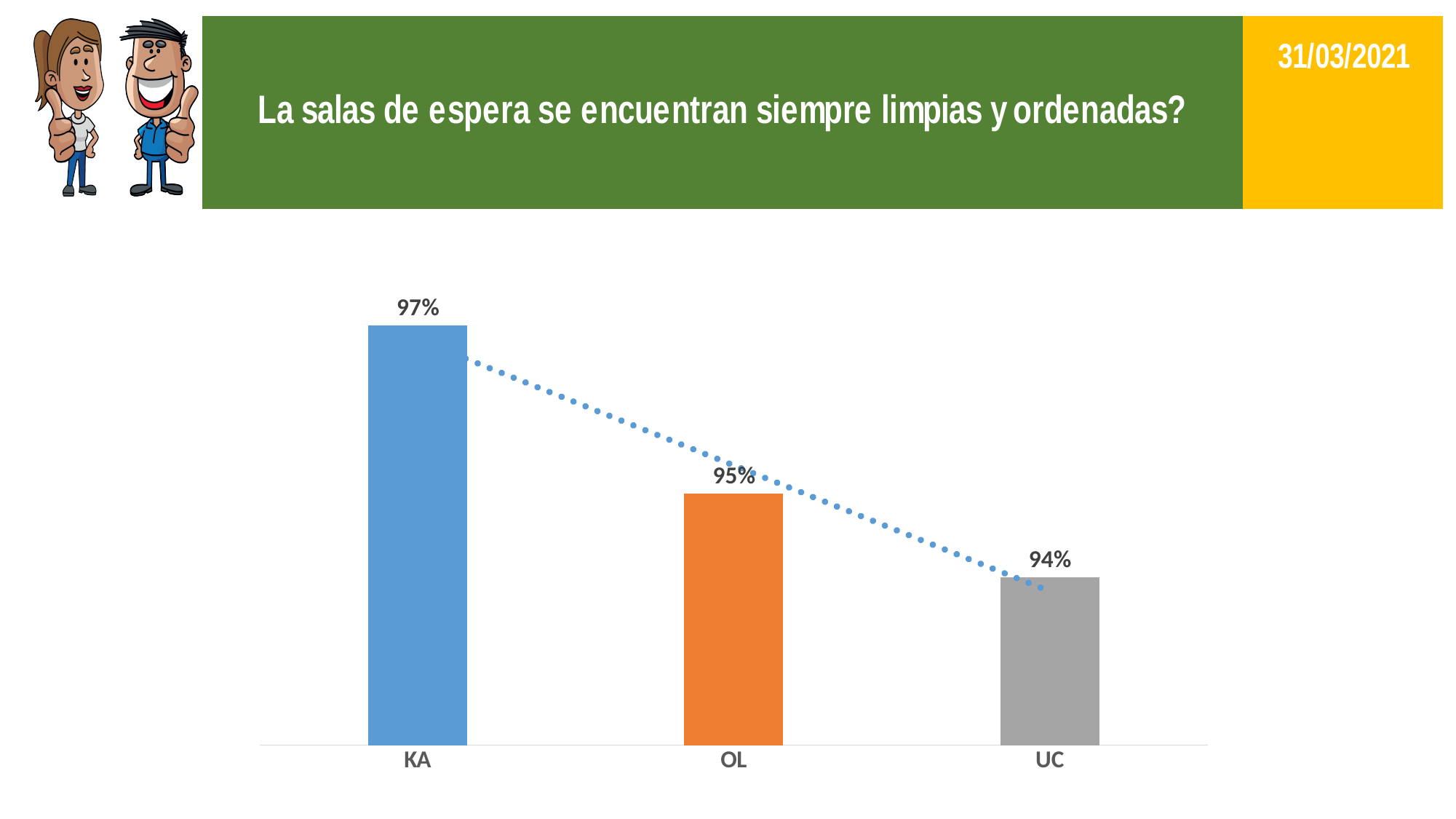
What is the value for KA? 97% Which is larger, the value for OL or the value for UC? OL Do the values rise or fall from KA to UC along the x axis? Fall What is the value for UC? 94% How many categories are shown on the chart? 3 What is the value for OL? 95% What is the difference between the values for KA and OL? 2% Which category has the highest value? KA What is the difference between the values for KA and UC? 3% Which category has the lowest value? UC What kind of chart is shown on the slide? Bar chart What colour is the bar for OL? Orange